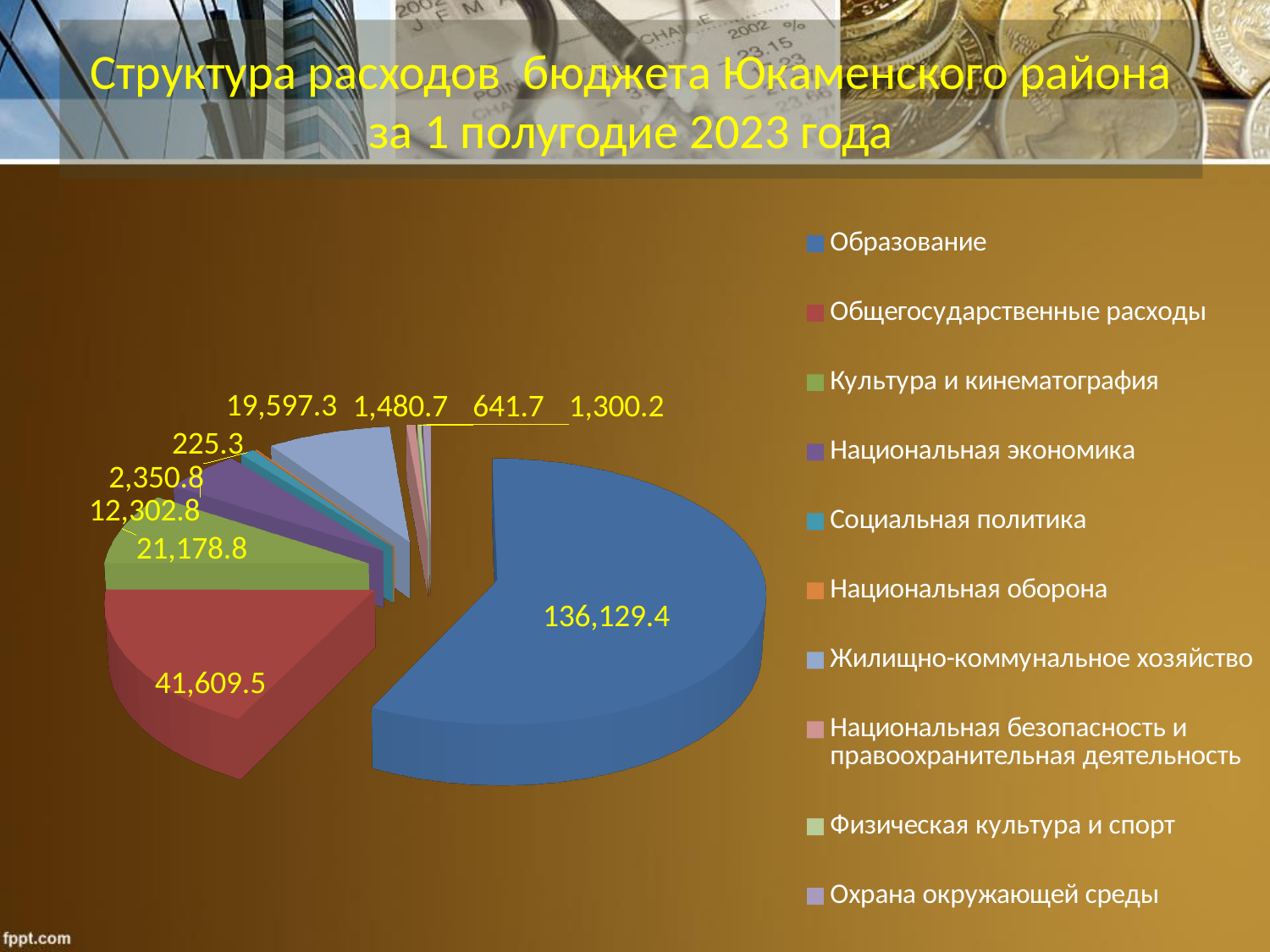
How many categories does the pie chart have? 10 What is the value for Жилищно-коммунальное хозяйство? 19,597.3 What kind of chart is shown on the slide? pie chart Which is larger, the value for Культура и кинематография or the value for Жилищно-коммунальное хозяйство? Культура и кинематография What is the value for Культура и кинематография? 21,178.8 What is the value for Национальная экономика? 12,302.8 Which category has the smallest value? Национальная оборона What is the title of the slide? Структура расходов бюджета Юкаменского района за 1 полугодие 2023 года What is the difference between the values for Образование and Общегосударственные расходы? 94,519.9 Which category has the largest slice of the pie? Образование What is the value for Образование? 136,129.4 What is the value for Общегосударственные расходы? 41,609.5